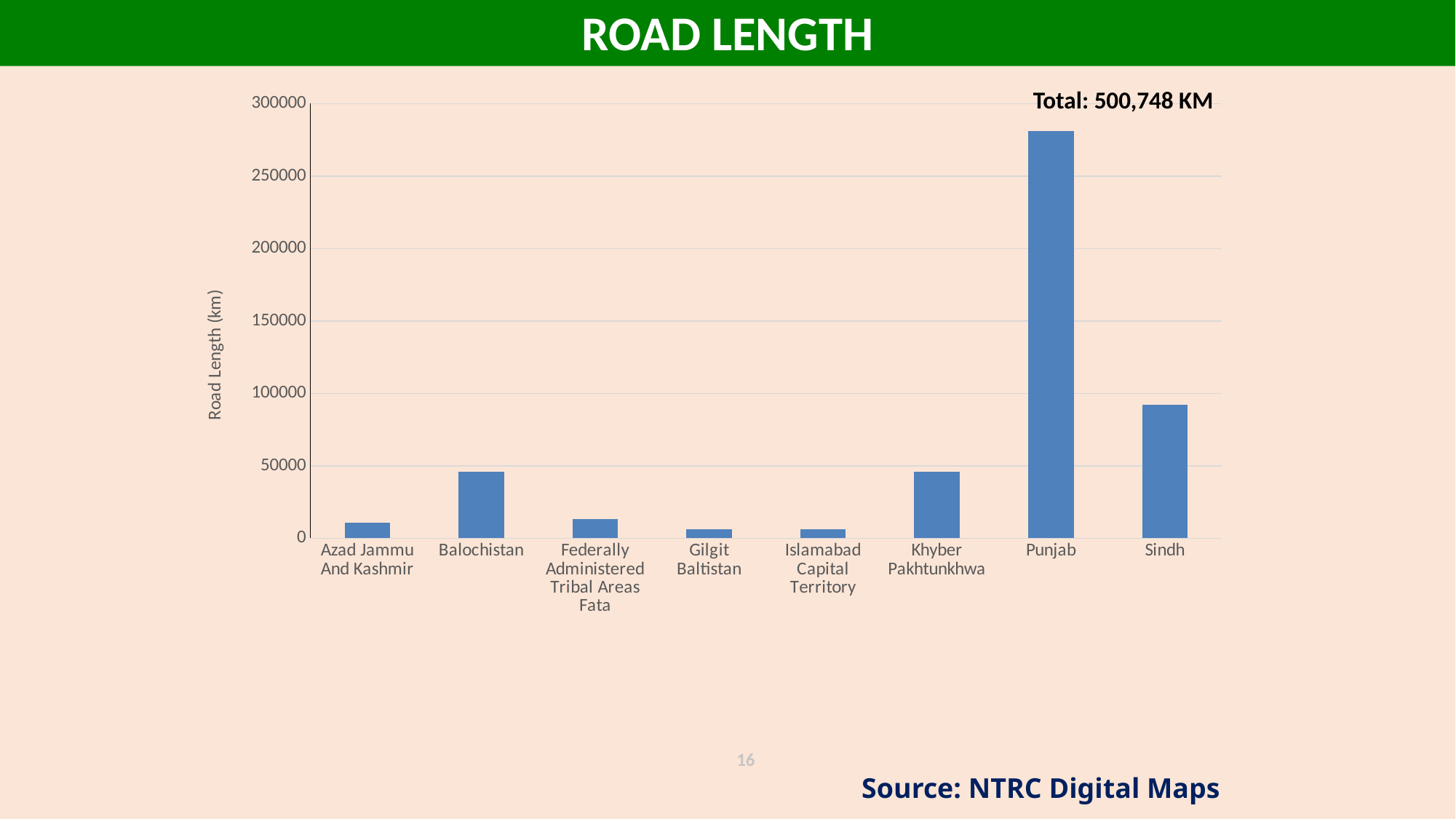
Is the road length for Azad Jammu And Kashmir greater or less than 50000? less Is the road length for Balochistan greater or less than 50000? less How many regions are shown on the x axis of the chart? 8 Is the road length for Sindh greater or less than 100000? less Which has a larger road length, Sindh or Khyber Pakhtunkhwa? Sindh What kind of chart is shown on the slide? bar chart Which has a larger road length, Federally Administered Tribal Areas Fata or Gilgit Baltistan? Federally Administered Tribal Areas Fata What total road length is stated on the slide? 500,748 KM Which has a larger road length, Balochistan or Azad Jammu And Kashmir? Balochistan Which region has the highest road length? Punjab What is the label of the y axis of the chart? Road Length (km)